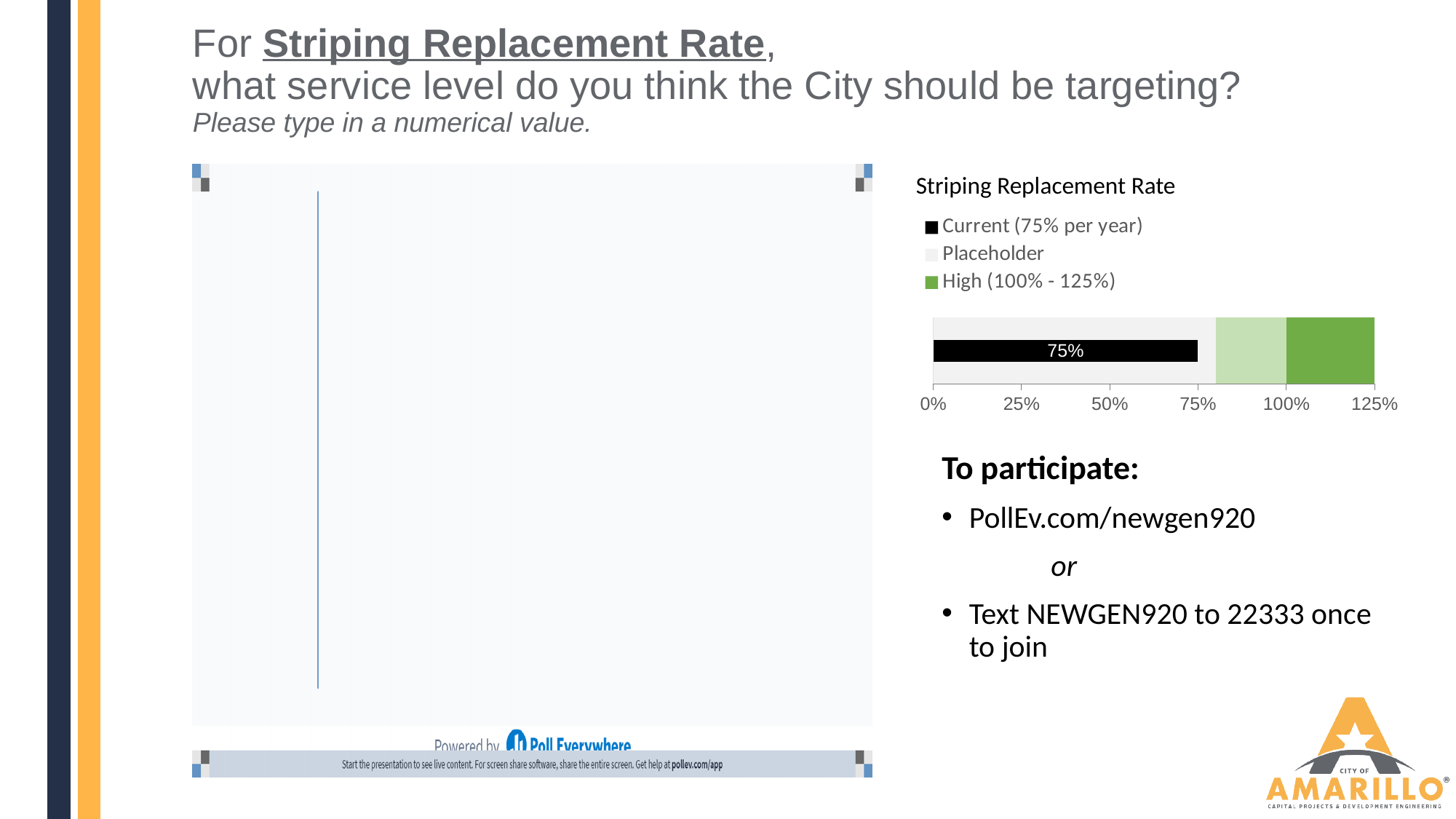
How many entries does the legend of the Striping Replacement Rate chart list? 3 What is the highest value shown on the x axis of the Striping Replacement Rate chart? 125% What value is printed on the black bar in the Striping Replacement Rate chart? 75% What kind of chart is the Striping Replacement Rate chart? bar chart Which legend entry in the Striping Replacement Rate chart is shown in green? High (100% - 125%) In the Striping Replacement Rate chart, is the value of the Current bar greater or less than 50%? greater What is the title of the chart on the slide? Striping Replacement Rate What is the full legend label for the black series in the Striping Replacement Rate chart? Current (75% per year) In the Striping Replacement Rate chart, is the value of the Current bar greater or less than 100%? less